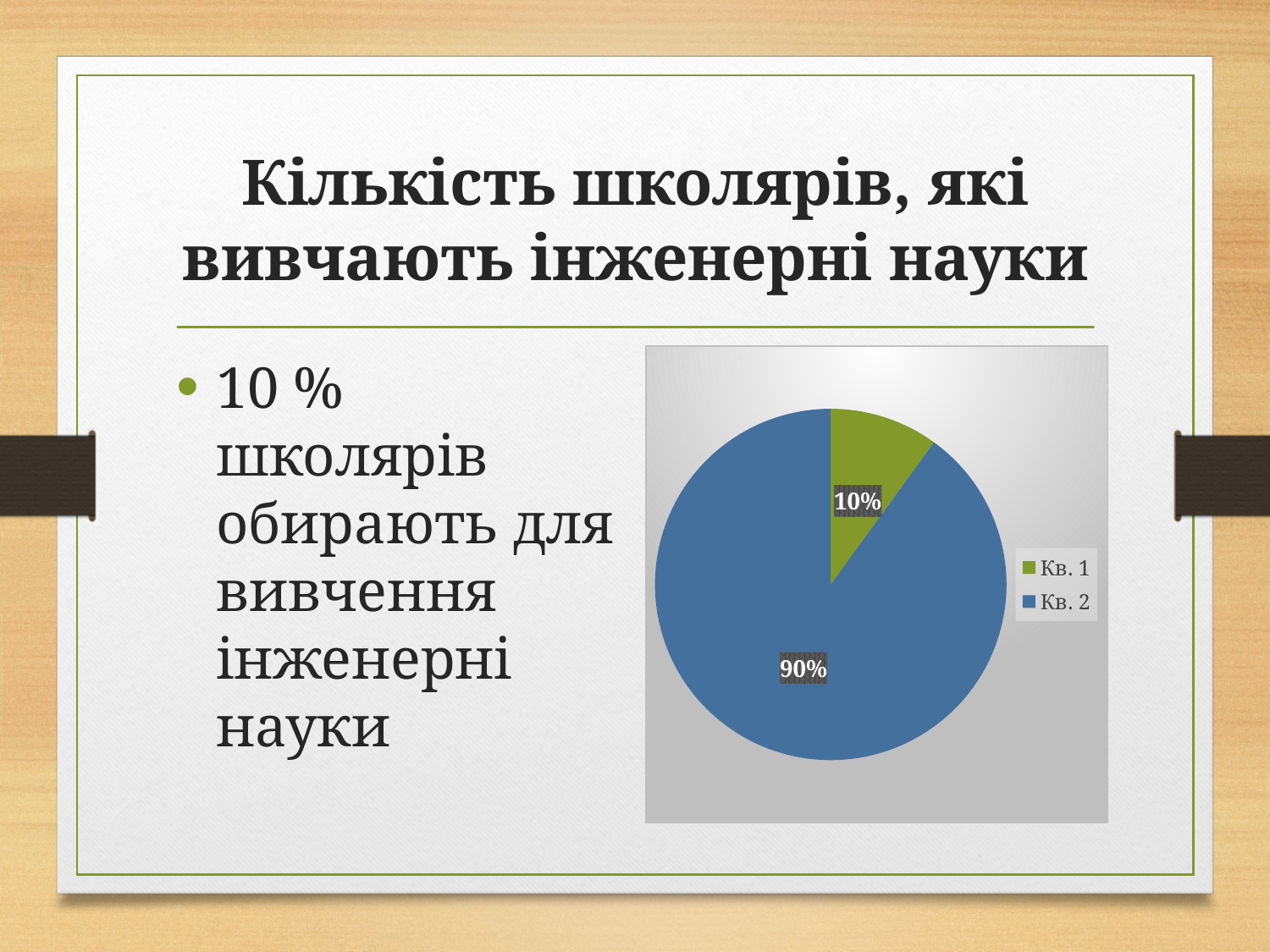
What colour is the Кв. 2 slice? blue Which slice of the pie is the largest? Кв. 2 How many slices does the pie chart have? 2 Which slice of the pie is the smallest? Кв. 1 What share of the pie does Кв. 1 represent? 10% What is the difference in percentage points between the Кв. 2 slice and the Кв. 1 slice? 80% How many entries does the legend list? 2 What share of the pie does Кв. 2 represent? 90% What kind of chart is shown on the slide? pie chart Which is larger, the Кв. 1 slice or the Кв. 2 slice? Кв. 2 What colour is the Кв. 1 slice? green